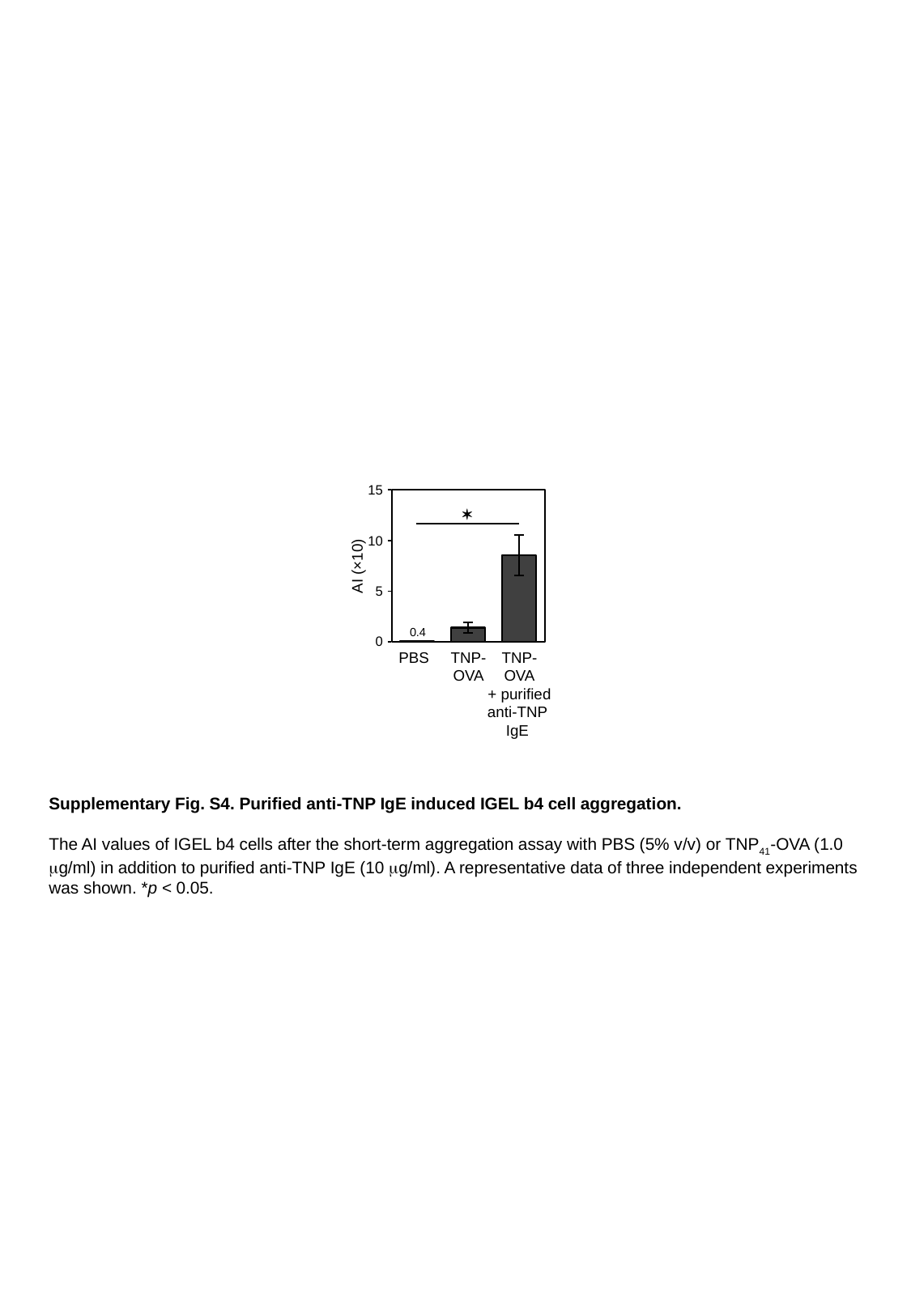
Is the value for TNP-OVA greater or less than 5? less Do the bar values rise or fall from left to right along the x axis? rise What is the AI (×10) value shown for PBS? 0.4 Is the value for TNP-OVA + purified anti-TNP IgE greater or less than 5? greater Which category has the lowest AI (×10) value? PBS Is the value for TNP-OVA + purified anti-TNP IgE greater or less than 10? less Which is larger, the value for TNP-OVA or the value for TNP-OVA + purified anti-TNP IgE? TNP-OVA + purified anti-TNP IgE Which category has the highest AI (×10) value? TNP-OVA + purified anti-TNP IgE How many categories are plotted on the x axis of the chart? 3 What is the highest tick value shown on the y axis? 15 What type of chart is shown on the slide? bar chart What is the label of the y axis? AI (×10)